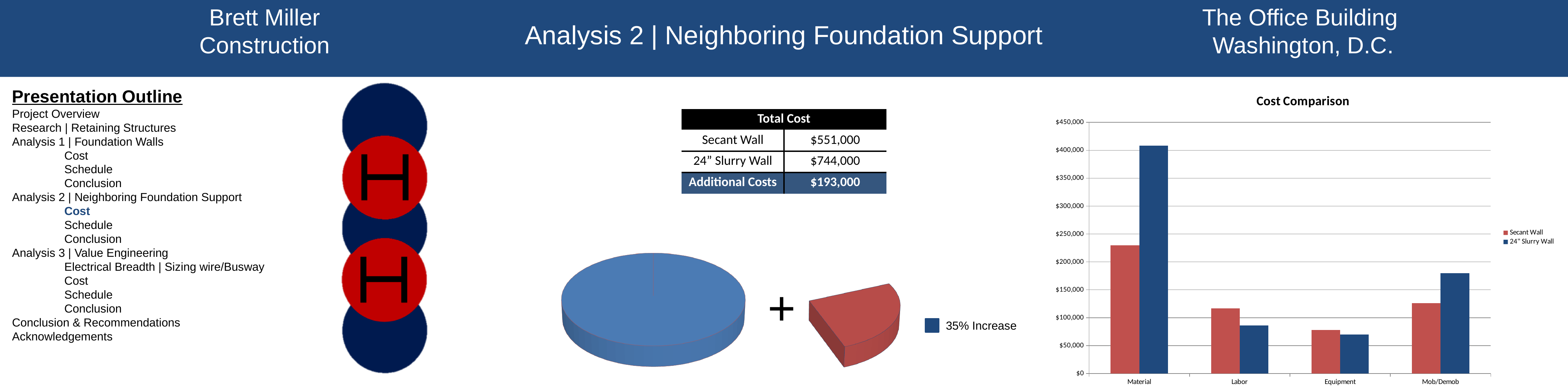
How many categories are shown on the x axis of the Cost Comparison chart? 4 What kind of chart is the Cost Comparison chart? bar chart In the Cost Comparison chart, for Labor, which is larger: Secant Wall or 24" Slurry Wall? Secant Wall In the Cost Comparison chart, which category has the highest Secant Wall value? Material How many series does the legend of the Cost Comparison chart list? 2 In the Cost Comparison chart, which category has the lowest Secant Wall value? Equipment In the Cost Comparison chart, is the 24" Slurry Wall value for Labor greater or less than $100,000? less In the Cost Comparison chart, which series has the tallest bar overall? 24" Slurry Wall In the Cost Comparison chart, for Material, which is larger: Secant Wall or 24" Slurry Wall? 24" Slurry Wall What is the title of the bar chart on the right of the slide? Cost Comparison In the Cost Comparison chart, is the 24" Slurry Wall value for Material greater or less than $350,000? greater In the Cost Comparison chart, is the 24" Slurry Wall value for Mob/Demob greater or less than $150,000? greater